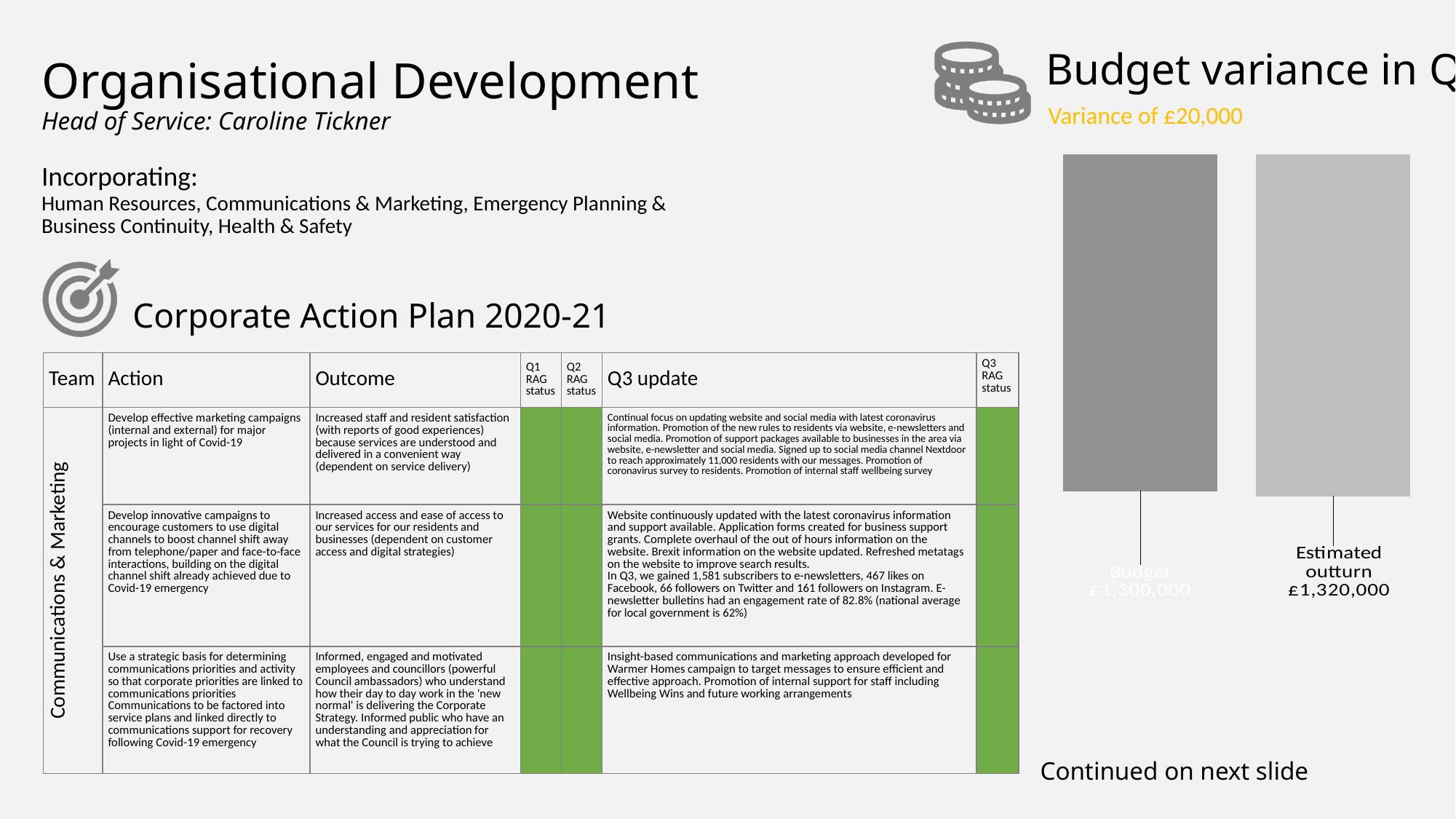
What kind of chart is the budget variance chart on the right of the slide? Bar chart In the budget variance chart, which category has the lowest value? Budget What are the two category labels shown under the bars in the budget variance chart? Budget and Estimated outturn What is the value of the Budget bar in the budget variance chart? £1,300,000 What is the difference between the Estimated outturn and the Budget in the budget variance chart? £20,000 How many bars are plotted in the budget variance chart? 2 What is the value of the Estimated outturn bar in the budget variance chart? £1,320,000 What variance amount is stated above the budget variance chart? Variance of £20,000 Do the values in the budget variance chart rise or fall from Budget to Estimated outturn? Rise In the budget variance chart, which bar has the higher value, Budget or Estimated outturn? Estimated outturn